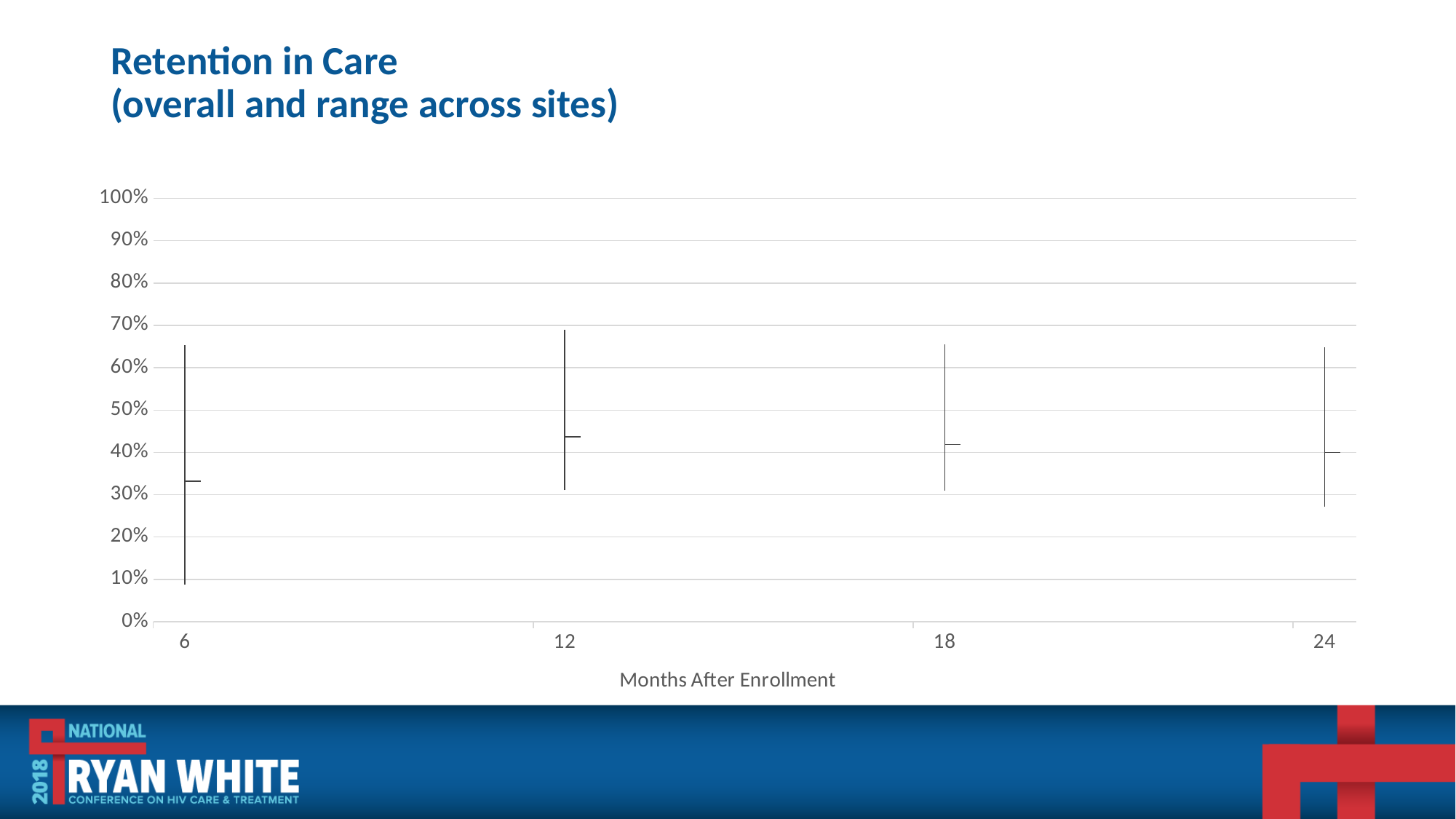
What is the title of the chart? Retention in Care (overall and range across sites) Which has the larger overall retention value, 6 months or 12 months after enrollment? 12 months Is the bottom of the range across sites at 24 months greater or less than 30%? less Is the overall retention value at 12 months greater or less than 40%? greater Is the overall retention value at 6 months greater or less than 30%? greater Does the overall retention value rise or fall from 6 months to 12 months after enrollment? rise At which number of months after enrollment is the overall retention value lowest? 6 How many time points (months after enrollment) are plotted on the chart? 4 What is the label of the x axis? Months After Enrollment